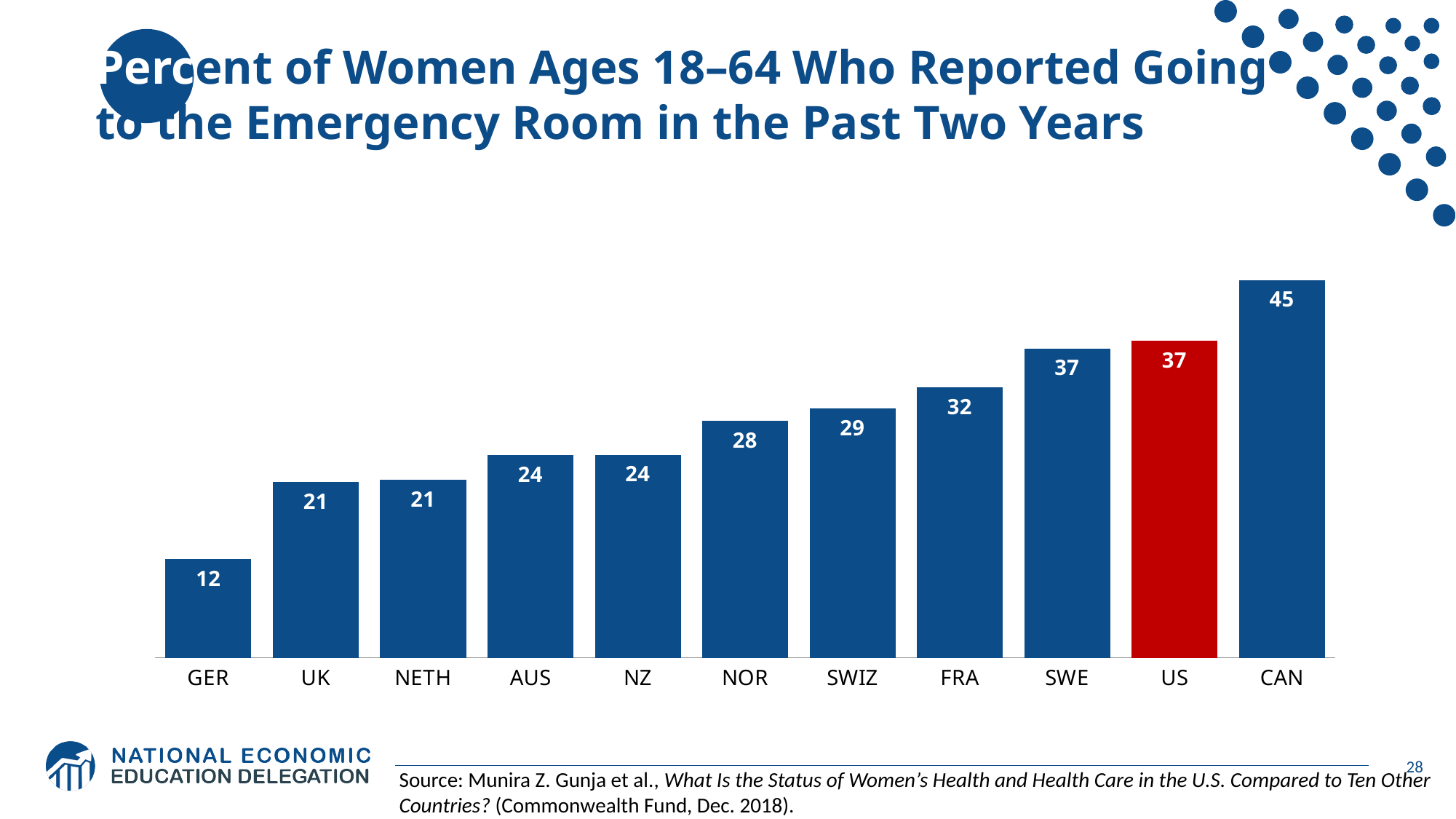
What kind of chart is this? bar chart What is the value for GER? 12 What is the difference between the values for FRA and GER? 20 Which bar is coloured red instead of blue? US Which country has the highest value? CAN Do the values rise or fall from left to right along the x axis? rise Which country has the lowest value? GER Which is larger, the value for SWIZ or the value for UK? SWIZ How many countries are shown on the chart? 11 What is the value for the US? 37 What is the difference between the values for CAN and the US? 8 What is the value for NOR? 28